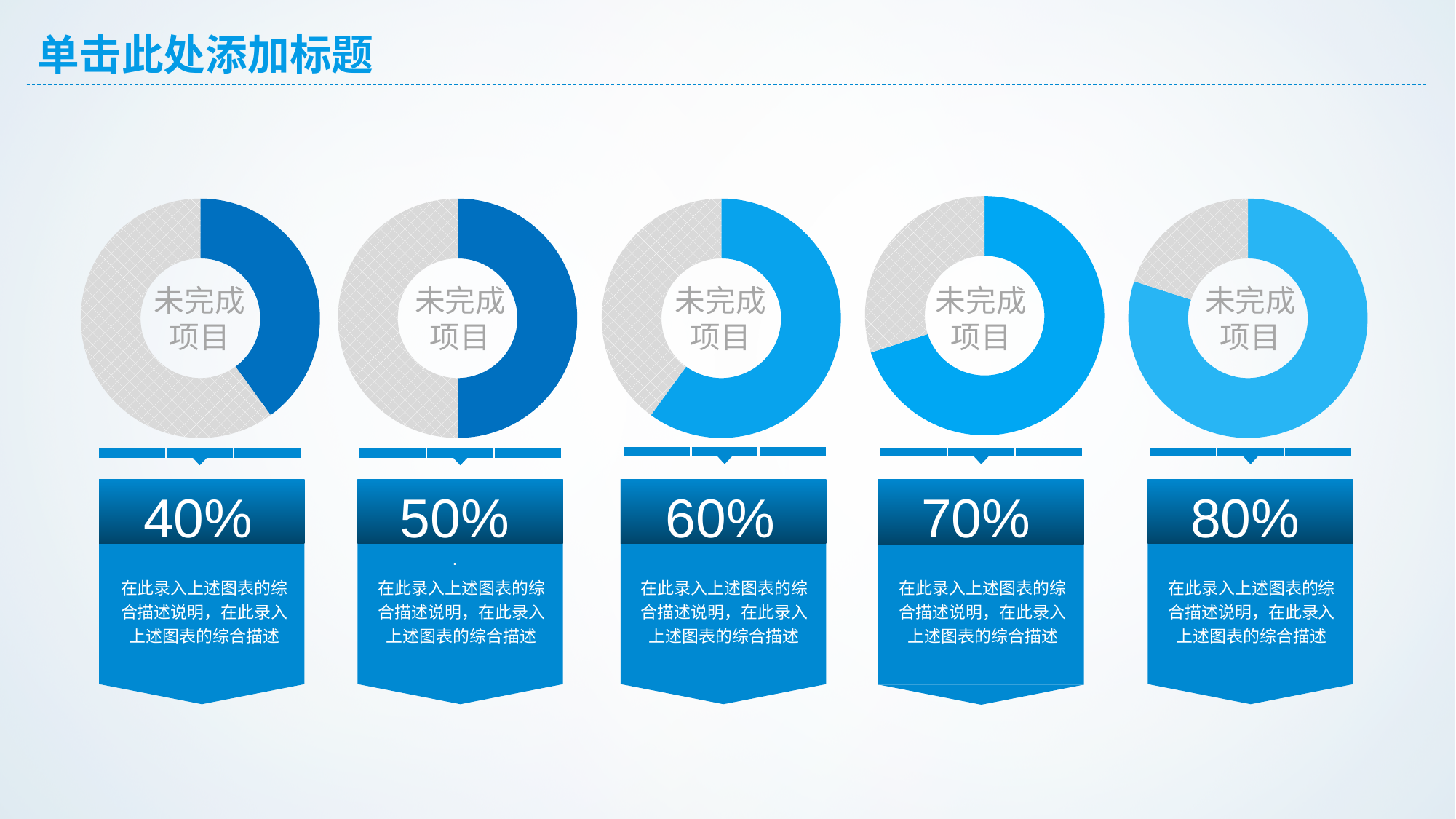
What is the difference between the percentage of the rightmost donut chart and the leftmost donut chart? 40% Which donut chart shows the highest percentage? The rightmost (80%) Do the percentages rise or fall from left to right across the donut charts? Rise What percentage is shown below the middle (third) donut chart? 60% What percentage is shown below the rightmost donut chart? 80% Which is larger: the percentage of the second donut chart or the fourth donut chart? The fourth (70%) What kind of chart is used on this slide? Donut chart What percentage is shown below the fourth donut chart from the left? 70% Which donut chart shows the lowest percentage? The leftmost (40%) How many donut charts are on the slide? 5 What text appears in the center of each donut chart? 未完成项目 What percentage is shown below the leftmost donut chart? 40%